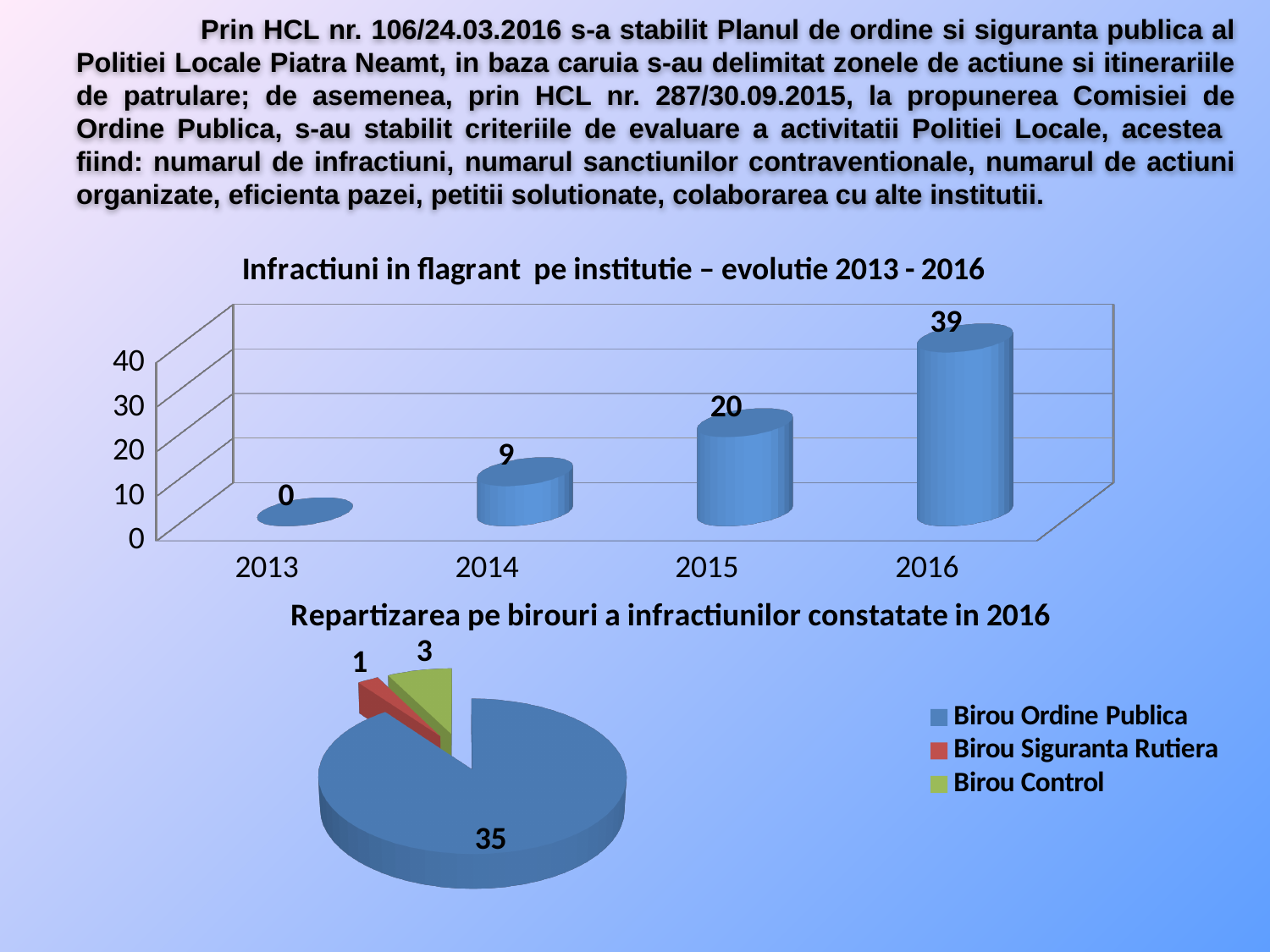
In the chart 'Infractiuni in flagrant pe institutie – evolutie 2013 - 2016', which year has the lowest value? 2013 In the chart 'Infractiuni in flagrant pe institutie – evolutie 2013 - 2016', what is the difference between the values for 2016 and 2015? 19 In the chart 'Infractiuni in flagrant pe institutie – evolutie 2013 - 2016', what is the value for 2014? 9 In the pie chart 'Repartizarea pe birouri a infractiunilor constatate in 2016', what is the value for Birou Ordine Publica? 35 In the chart 'Infractiuni in flagrant pe institutie – evolutie 2013 - 2016', how many years are shown on the x axis? 4 What kind of chart is 'Infractiuni in flagrant pe institutie – evolutie 2013 - 2016'? bar chart In the chart 'Infractiuni in flagrant pe institutie – evolutie 2013 - 2016', which year has the highest value? 2016 In the pie chart 'Repartizarea pe birouri a infractiunilor constatate in 2016', which is larger, Birou Siguranta Rutiera or Birou Control? Birou Control In the chart 'Infractiuni in flagrant pe institutie – evolutie 2013 - 2016', do the values rise or fall from 2013 to 2016? rise In the pie chart 'Repartizarea pe birouri a infractiunilor constatate in 2016', what is the value for Birou Control? 3 In the chart 'Infractiuni in flagrant pe institutie – evolutie 2013 - 2016', what is the value for 2015? 20 How many entries does the legend of the pie chart 'Repartizarea pe birouri a infractiunilor constatate in 2016' list? 3